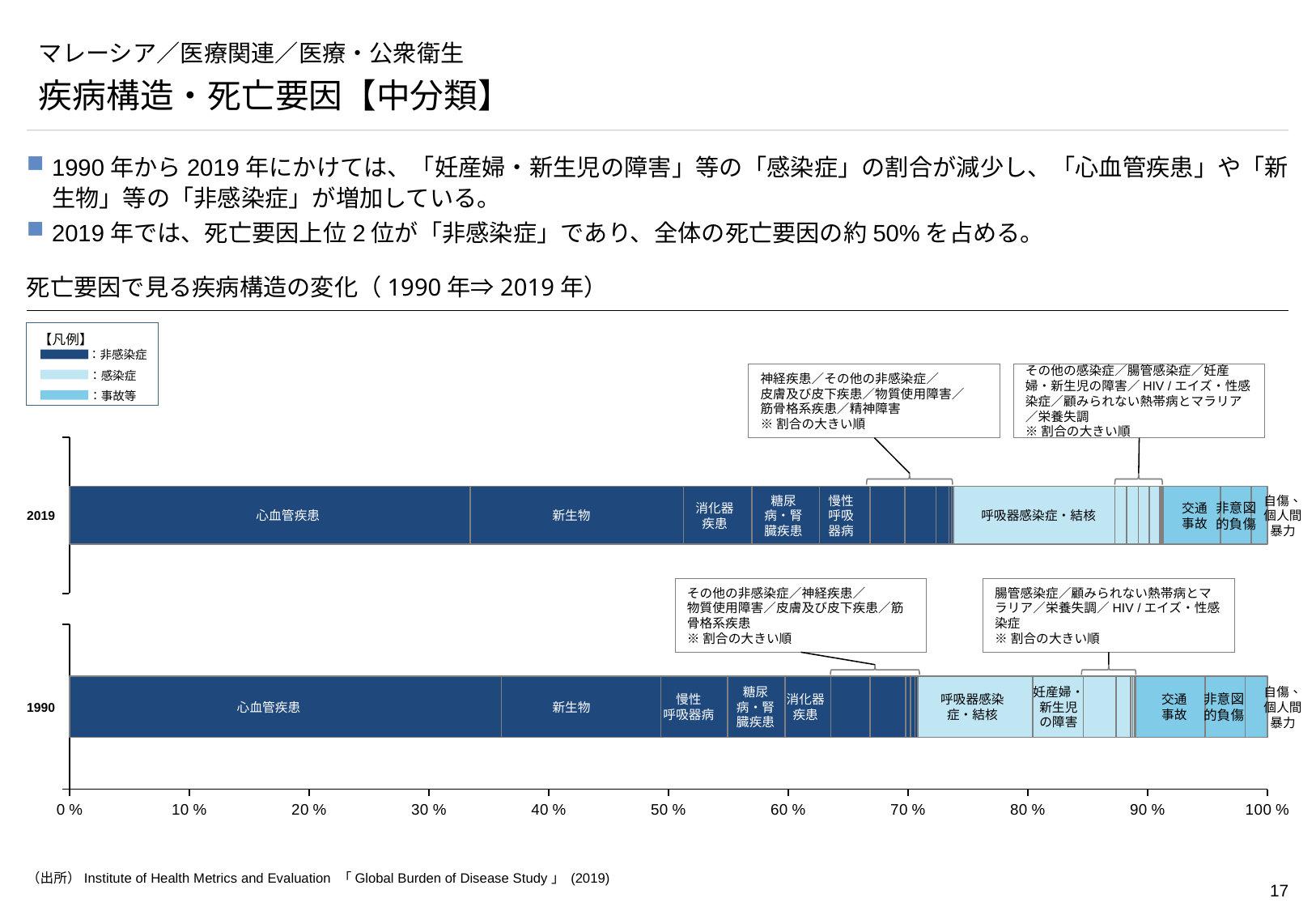
Is the share of 心血管疾患 in 1990 greater or less than 30%? greater Is the share of 新生物 in 2019 greater or less than 10%? greater How many bars (years) does the chart show? 2 How many categories does the legend (凡例) list? 3 Is the share of 心血管疾患 in 1990 greater or less than 40%? less Which legend category is shown in dark blue? 非感染症 What kind of chart is shown on the slide? Stacked bar chart Which year has the larger share for 呼吸器感染症・結核, 1990 or 2019? 2019 What is the title of the chart? 死亡要因で見る疾病構造の変化（1990年⇒2019年） Which cause of death has the largest share in the 2019 bar? 心血管疾患 Which cause of death has the largest share in the 1990 bar? 心血管疾患 Which year has the larger share for 新生物, 1990 or 2019? 2019